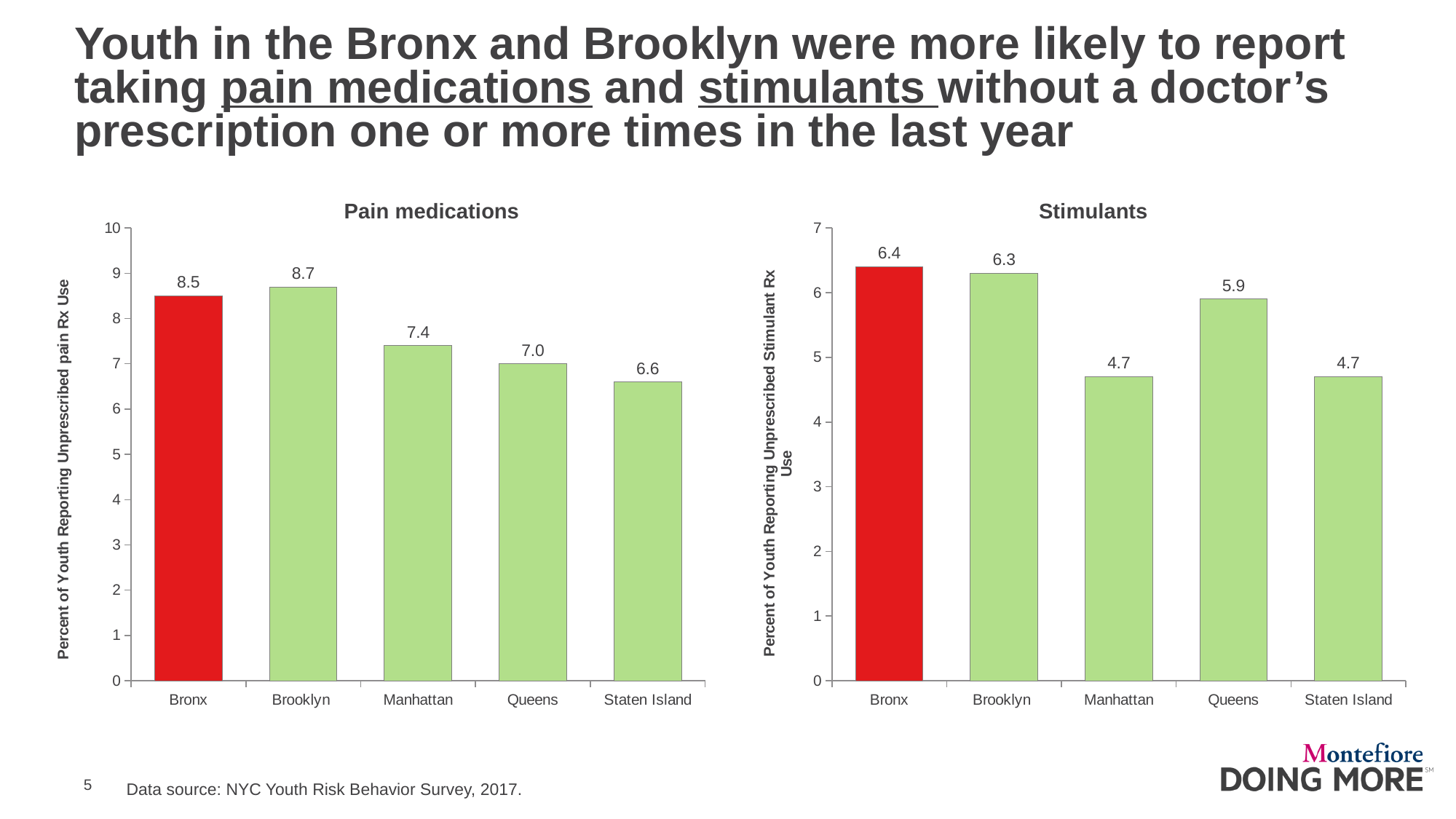
In the Stimulants chart, which bar is coloured red? Bronx In the Pain medications chart, what is the difference between the Bronx and Staten Island values? 1.9 In the Stimulants chart, what is the difference between the Brooklyn and Manhattan values? 1.6 What kind of chart is the Stimulants chart? bar chart In the Stimulants chart, which borough has the highest value? Bronx In the Pain medications chart, which is larger, the value for Manhattan or the value for Queens? Manhattan In the Pain medications chart, which borough has the lowest value? Staten Island How many boroughs are shown in the Pain medications chart? 5 In the Stimulants chart, is the value for Queens greater or less than 5? greater What is the title of the chart on the left side of the slide? Pain medications In the Stimulants chart, what is the value for Queens? 5.9 In the Pain medications chart, what is the value for Brooklyn? 8.7